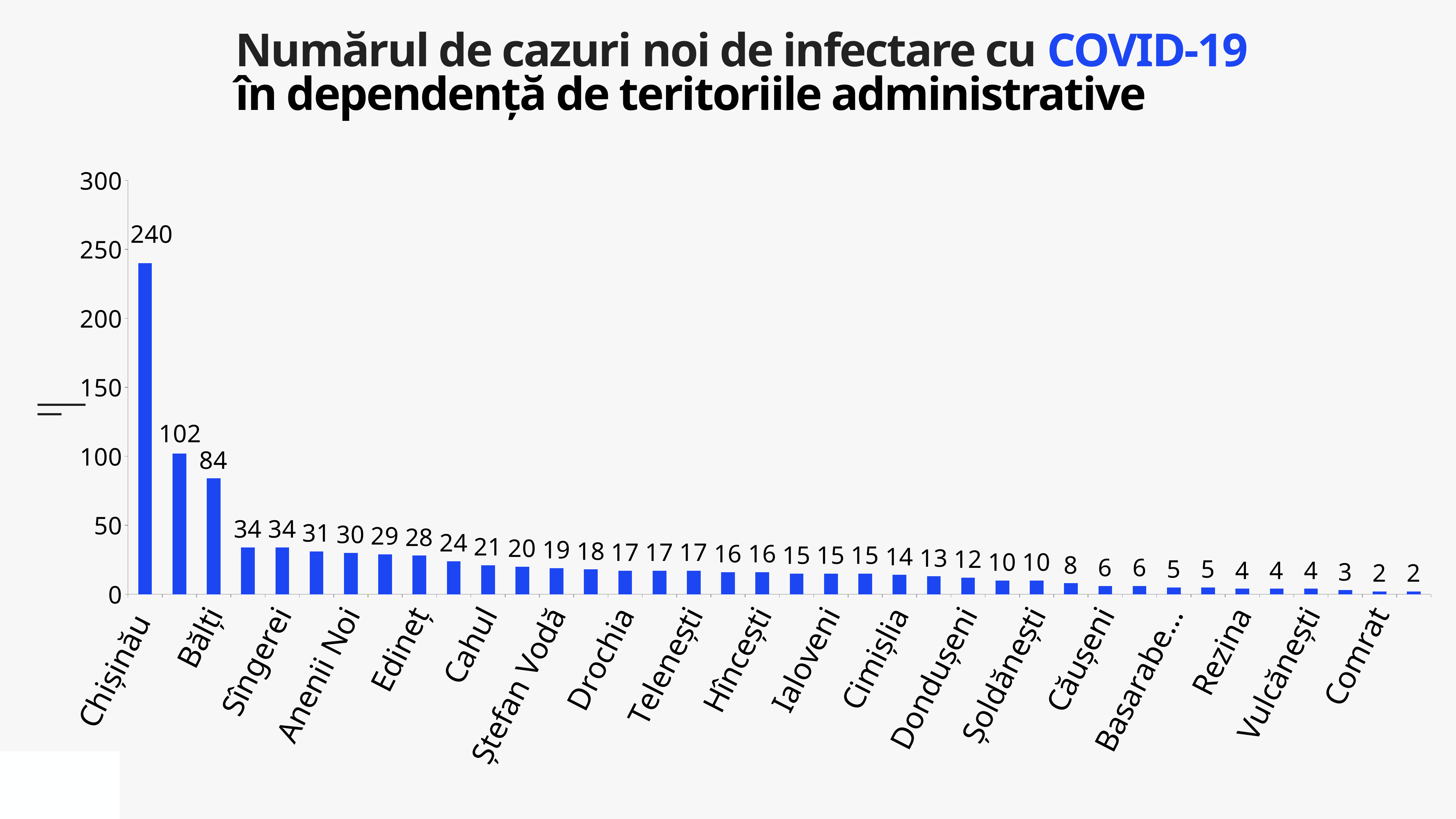
How many new COVID-19 cases are shown for Chișinău? 240 Is the value for Chișinău greater or less than 200? greater How many new cases are shown for Comrat? 2 What is the highest tick value shown on the vertical axis? 300 How many bars are plotted in the chart? 38 Which administrative territory has the highest number of new COVID-19 cases? Chișinău Do the values rise or fall from left to right along the x axis? fall What colour are the bars in the chart? blue What is the value of the second-highest bar in the chart? 102 What is the lowest value shown on any bar in the chart? 2 What type of chart is shown on the slide? bar chart What is the difference between the highest bar (240) and the second-highest bar (102)? 138